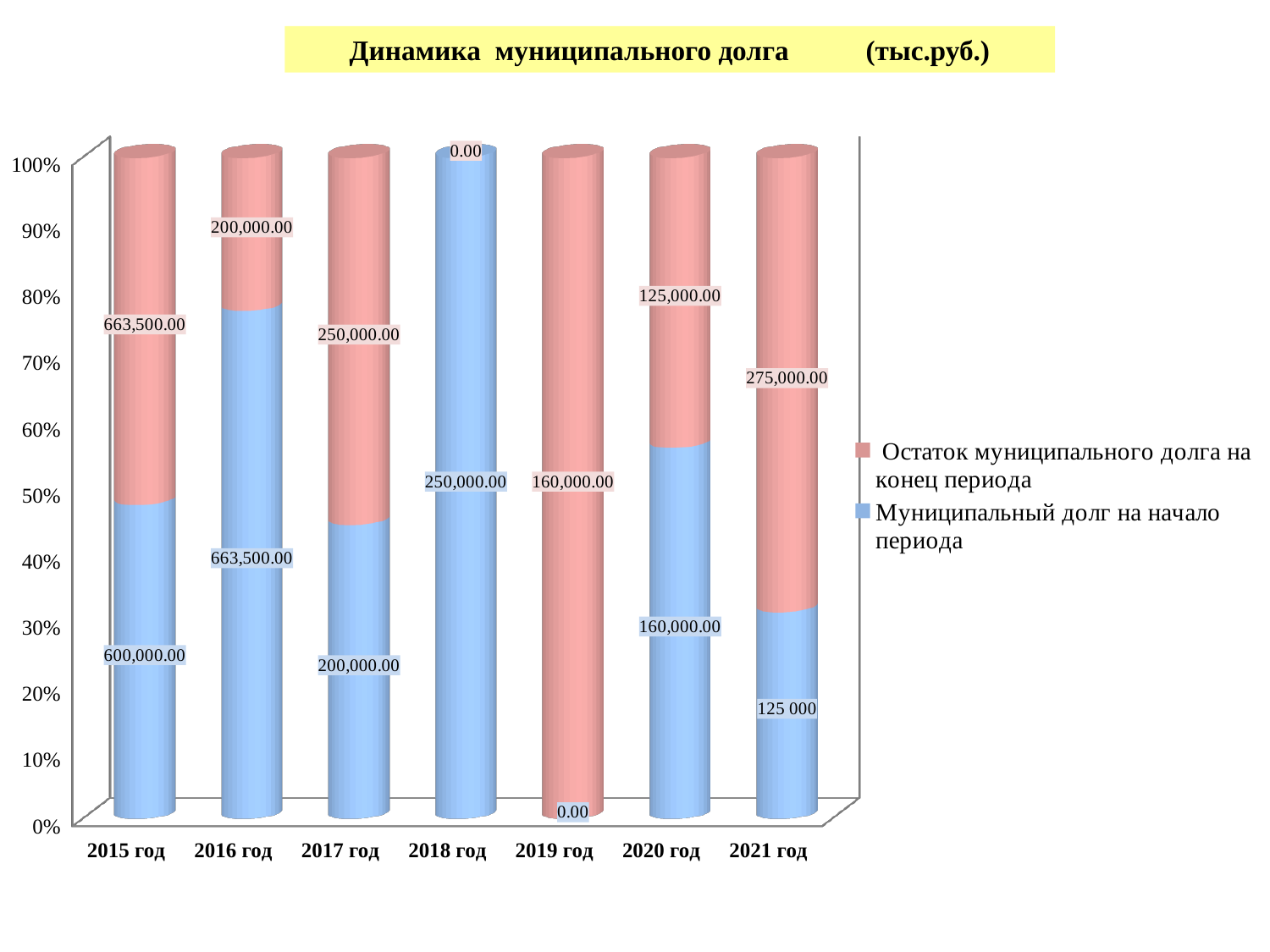
What kind of chart is shown on the slide? Stacked bar chart How many years are shown on the x axis? 7 What is the value of 'Остаток муниципального долга на конец периода' for 2021 год? 275,000.00 In which year is 'Остаток муниципального долга на конец периода' the lowest? 2018 год What is the value of 'Муниципальный долг на начало периода' for 2015 год? 600,000.00 For 2020 год, which is larger: the debt at the start of the period or the remaining debt at the end of the period? Муниципальный долг на начало периода What is the title of the chart? Динамика муниципального долга (тыс.руб.) What is the difference between 'Остаток муниципального долга на конец периода' and 'Муниципальный долг на начало периода' for 2021 год? 150,000.00 In which year is 'Муниципальный долг на начало периода' the highest? 2016 год How many series does the legend list? 2 What is the value of 'Остаток муниципального долга на конец периода' for 2016 год? 200,000.00 What is the value of 'Муниципальный долг на начало периода' for 2019 год? 0.00